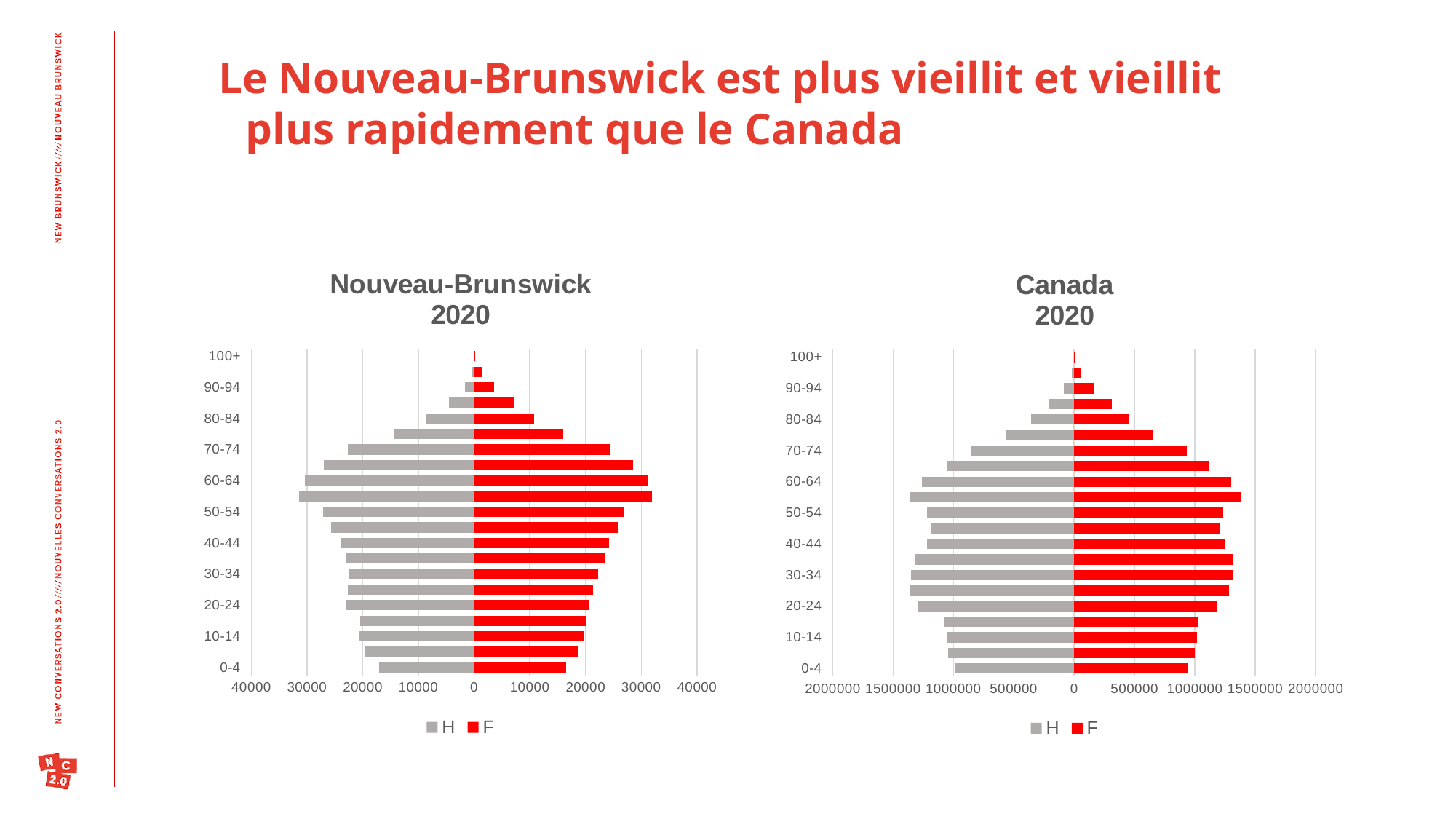
In the Nouveau-Brunswick 2020 chart, which is larger: the F value for 60-64 or the F value for 0-4? 60-64 In the Canada 2020 chart, which is larger: the H value for 30-34 or the H value for 80-84? 30-34 In the Canada 2020 chart, is the F value for 60-64 greater or less than 1000000? greater In the Nouveau-Brunswick 2020 chart, is the F value for 0-4 greater or less than 20000? less In the Nouveau-Brunswick 2020 chart, is the H value for 80-84 greater or less than 10000? less In the Nouveau-Brunswick 2020 chart, which age group has the lowest F value? 100+ In the Canada 2020 chart, which age group has the lowest H value? 100+ What are the two legend entries on the Nouveau-Brunswick 2020 chart? H and F What kind of chart is the Nouveau-Brunswick 2020 chart? bar chart How many series does the legend of the Canada 2020 chart list? 2